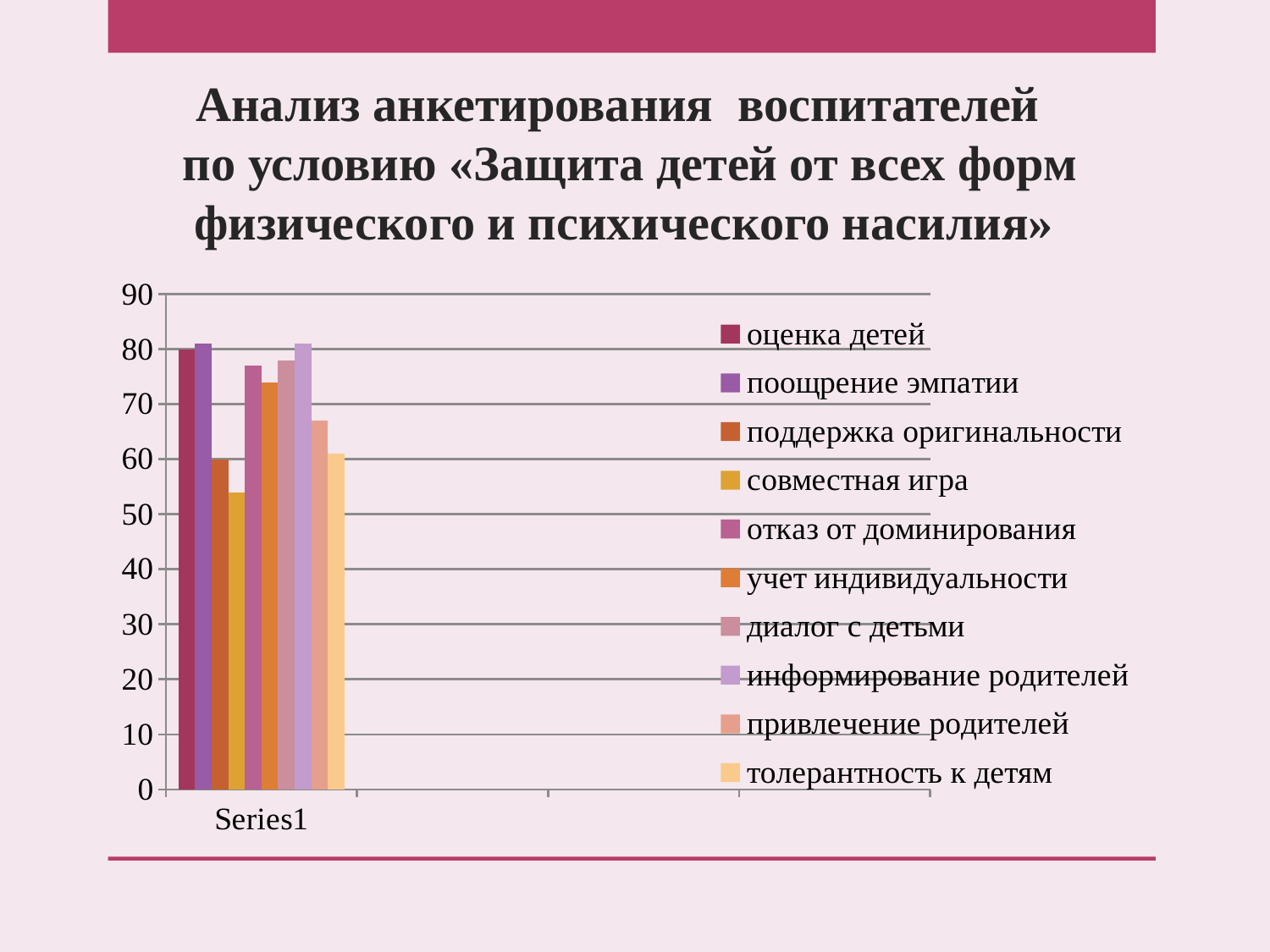
What is the first entry listed in the legend? оценка детей Is the value for толерантность к детям greater or less than 70? less How many series does the legend list? 10 What kind of chart is shown on the slide? bar chart What label appears under the group of bars on the x axis? Series1 Is the value for привлечение родителей greater or less than 70? less Is the value for совместная игра greater or less than 60? less Which is larger, the value for оценка детей or the value for совместная игра? оценка детей Which series has the lowest value? совместная игра Which is larger, the value for поддержка оригинальности or the value for учет индивидуальности? учет индивидуальности